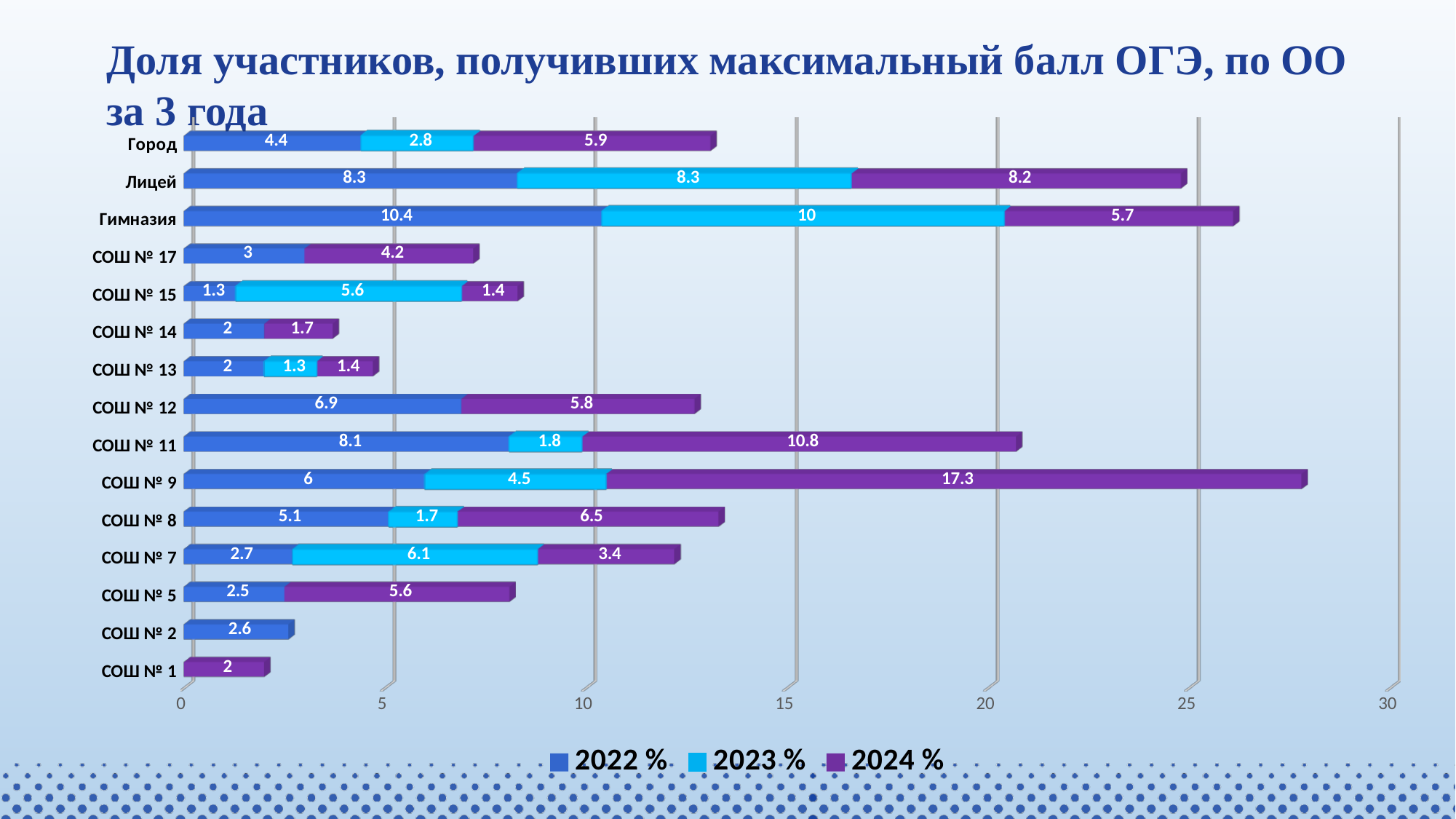
Which is larger for СОШ № 7: the 2023 % value or the 2024 % value? 2023 % What is the difference between the 2024 % and 2022 % values for СОШ № 11? 2.7 How many categories (organisations) are shown on the vertical axis? 15 What is the 2022 % value for СОШ № 11? 8.1 What is the 2024 % value for СОШ № 9? 17.3 Which organisation has the highest 2022 % value? Гимназия What is the total of the stacked bar for Город? 13.1 What is the title of the chart? Доля участников, получивших максимальный балл ОГЭ, по ОО за 3 года How many series does the legend list? 3 Which organisation has the highest 2024 % value? СОШ № 9 What type of chart is shown on the slide? Stacked bar chart What is the 2023 % value for Гимназия? 10